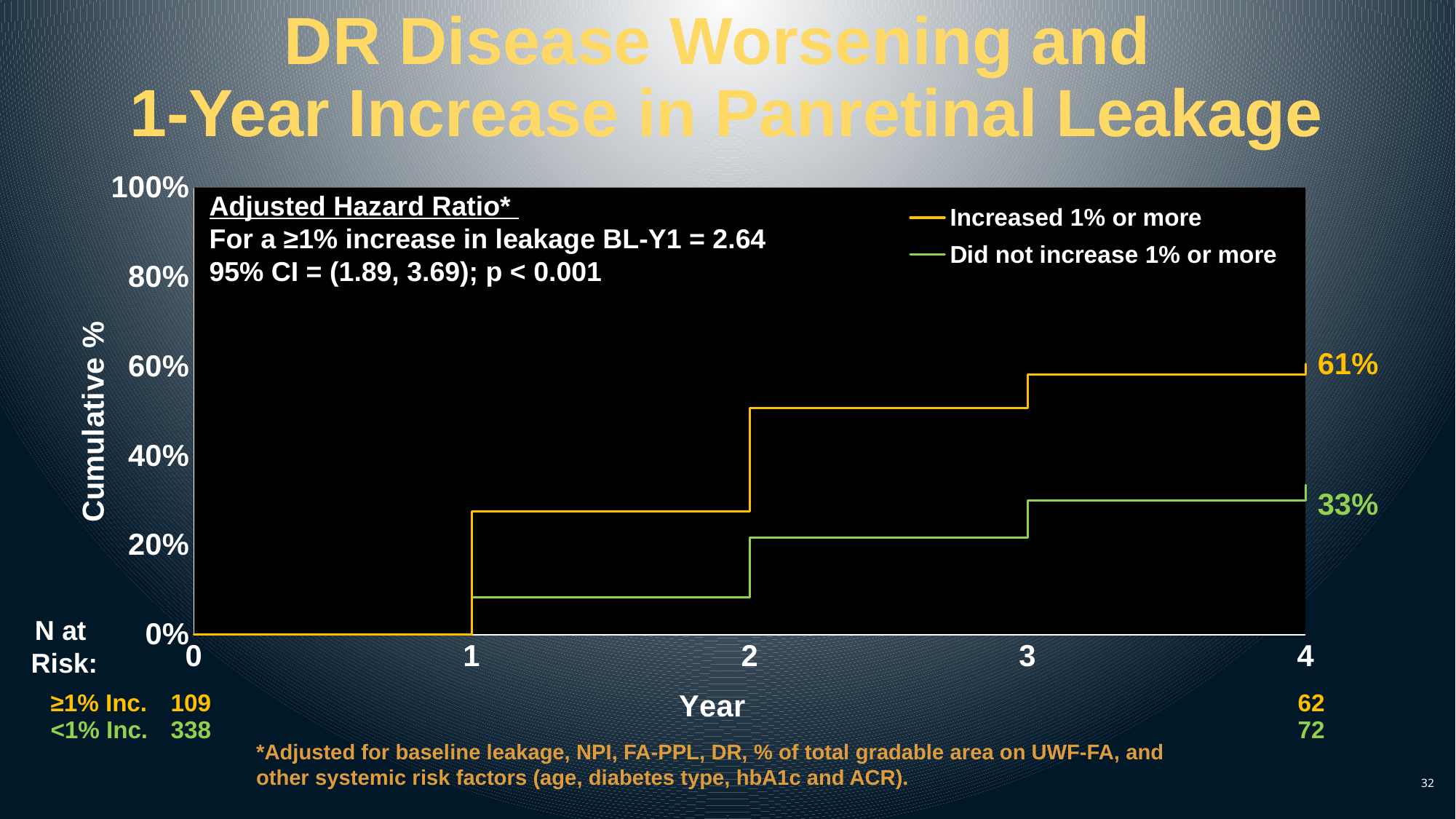
Is the cumulative % for the 'Did not increase 1% or more' group at year 1 greater or less than 20%? less What is the cumulative % at year 4 for the 'Did not increase 1% or more' group? 33% What is the cumulative % at year 4 for the 'Increased 1% or more' group? 61% What is the label of the y axis? Cumulative % Which group has the higher cumulative % at year 4? Increased 1% or more Do the cumulative % values for both groups rise or fall as the year increases? Rise What is the number at risk at year 0 for the ≥1% Inc. group? 109 How many series does the legend list? 2 What is the difference between the year-4 cumulative % of the 'Increased 1% or more' group and the 'Did not increase 1% or more' group? 28% What kind of chart is shown on the slide? Step (Kaplan-Meier) line chart What is the adjusted hazard ratio for a ≥1% increase in leakage BL-Y1? 2.64